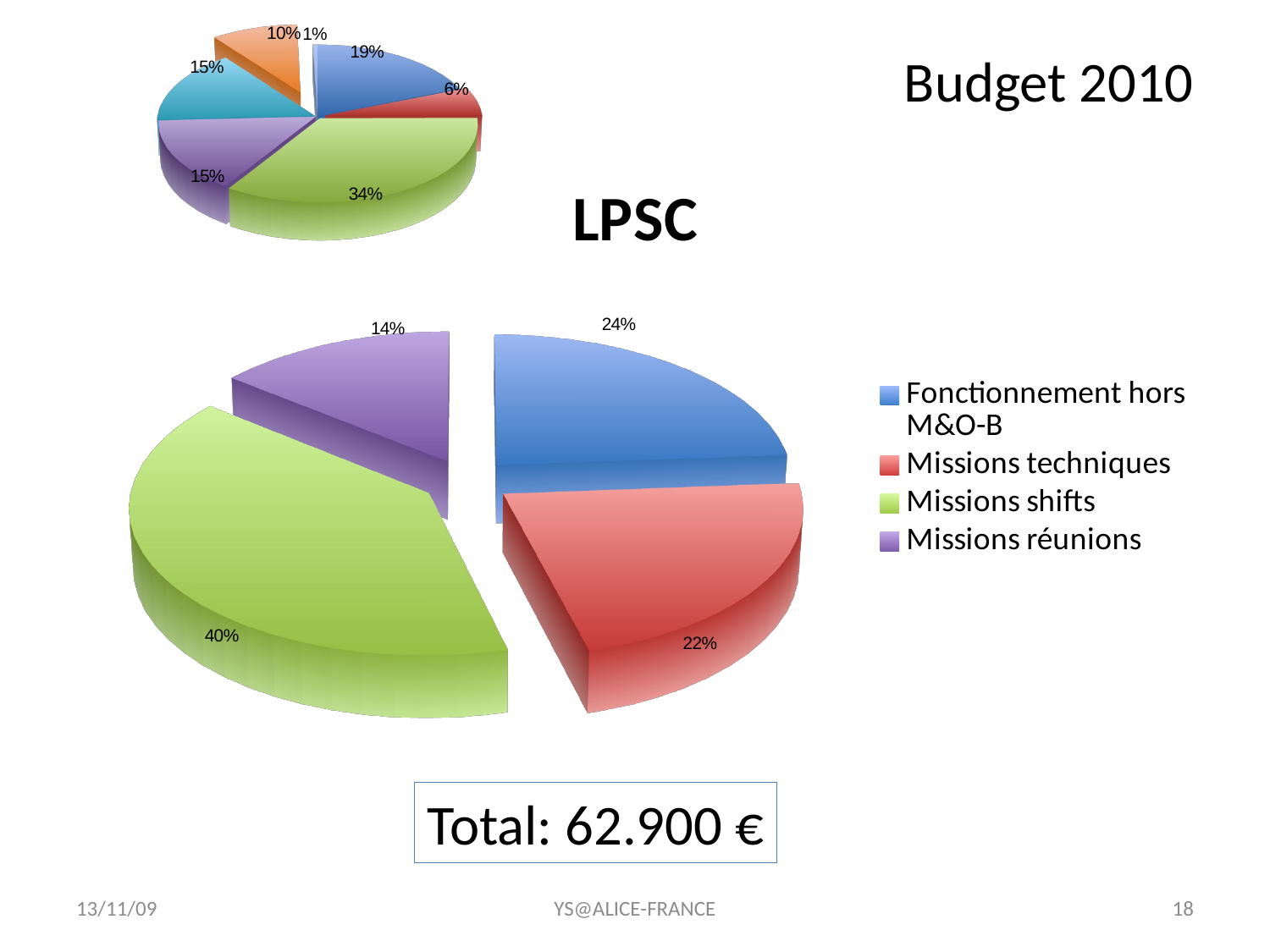
In the LPSC pie chart, what share does Missions techniques have? 22% In the LPSC pie chart, which category has the largest slice? Missions shifts In the LPSC pie chart, which is larger: Fonctionnement hors M&O-B or Missions techniques? Fonctionnement hors M&O-B In the LPSC pie chart, what share does Fonctionnement hors M&O-B have? 24% In the LPSC pie chart, what share does Missions réunions have? 14% In the small pie chart in the top-left corner of the slide, what is the percentage of the largest slice? 34% How many slices does the LPSC pie chart have? 4 What kind of chart is the LPSC chart? Pie chart In the LPSC pie chart, what is the difference in percentage points between Missions shifts and Missions techniques? 18% How many slices does the small pie chart in the top-left corner of the slide have? 7 In the LPSC pie chart, which category has the smallest slice? Missions réunions